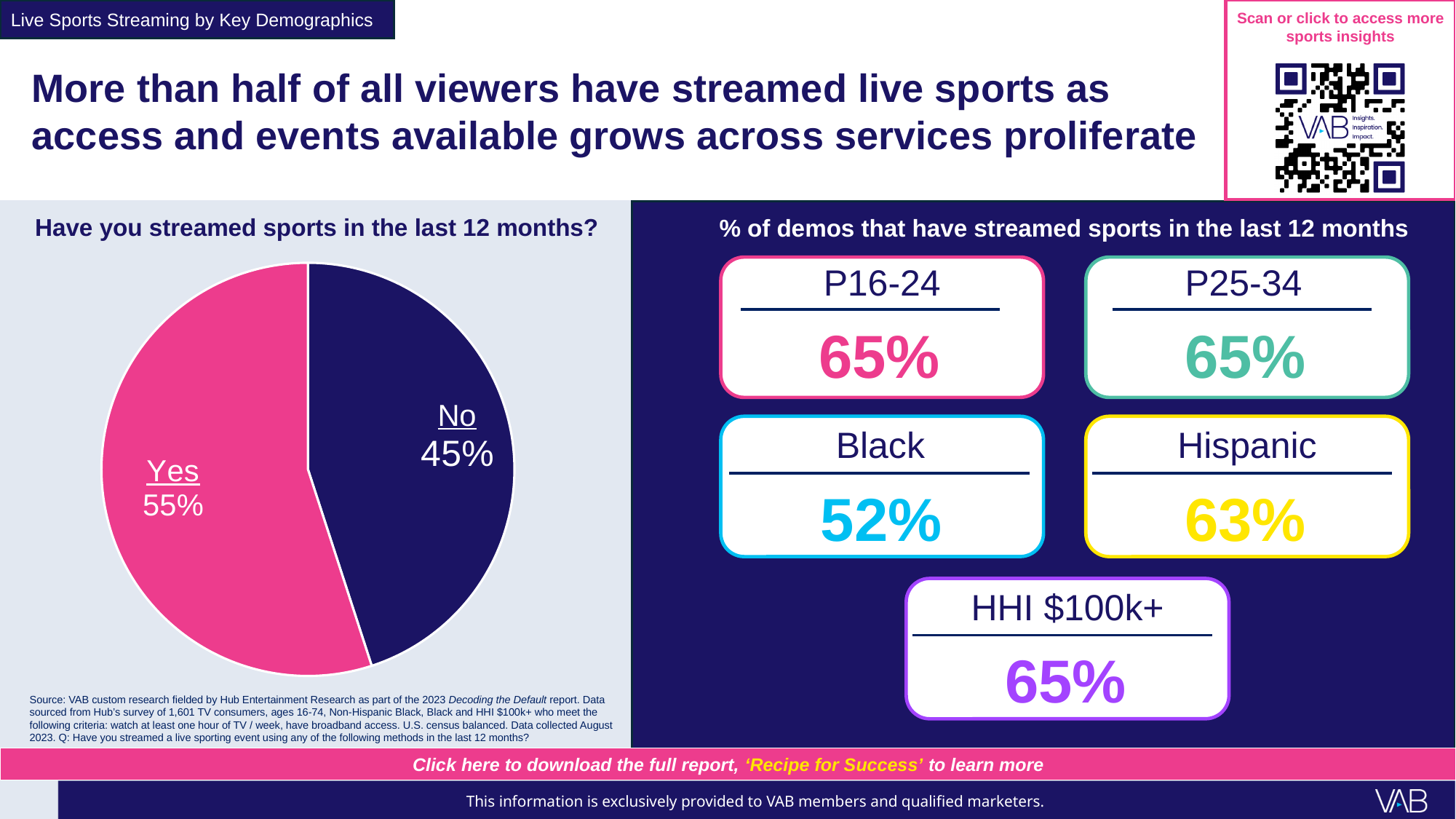
In the pie chart 'Have you streamed sports in the last 12 months?', which response has the smaller slice? No In the pie chart 'Have you streamed sports in the last 12 months?', how many slices are there? 2 In the pie chart 'Have you streamed sports in the last 12 months?', what share of viewers answered Yes? 55% In the '% of demos that have streamed sports in the last 12 months' panel, what is the value for Black viewers? 52% What type of chart is used to show the answers to 'Have you streamed sports in the last 12 months?' Pie chart In the pie chart 'Have you streamed sports in the last 12 months?', what is the difference in percentage points between the Yes and No slices? 10 percentage points In the '% of demos that have streamed sports in the last 12 months' panel, what is the value for Hispanic viewers? 63% In the '% of demos that have streamed sports in the last 12 months' panel, which demographic has the lowest value? Black In the pie chart 'Have you streamed sports in the last 12 months?', which response has the larger slice? Yes In the pie chart 'Have you streamed sports in the last 12 months?', is the Yes slice greater or less than 50%? greater In the pie chart 'Have you streamed sports in the last 12 months?', what share of viewers answered No? 45% In the pie chart 'Have you streamed sports in the last 12 months?', what colour is the Yes slice? Pink